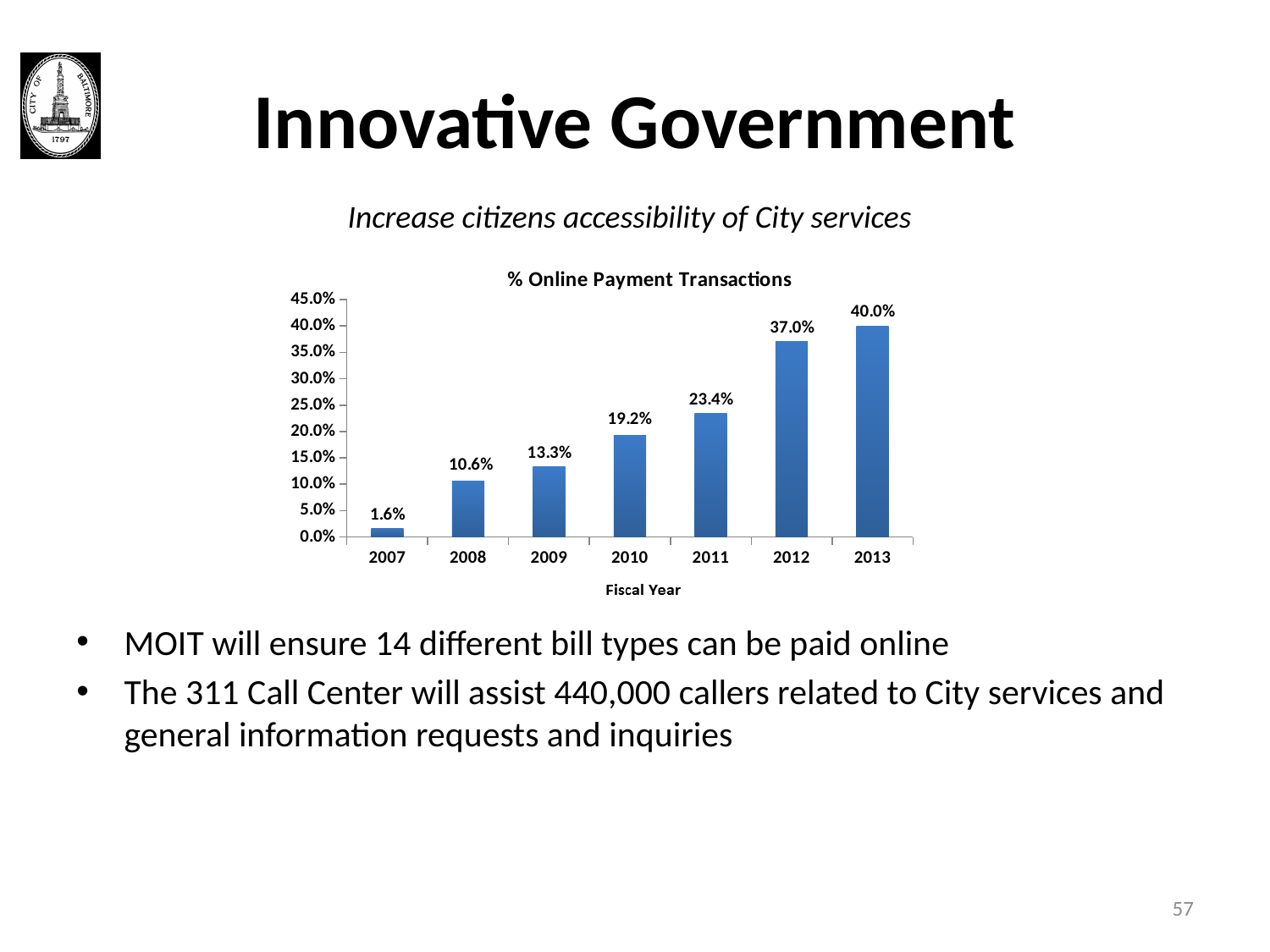
Is the value for 2011 greater or less than 20.0%? greater How many fiscal years are shown in the chart? 7 Do the % Online Payment Transactions values rise or fall from 2007 to 2013? Rise What is the % Online Payment Transactions value for fiscal year 2010? 19.2% Which fiscal year has the lowest % Online Payment Transactions? 2007 What is the difference in % Online Payment Transactions between 2013 and 2012? 3.0% What is the difference in % Online Payment Transactions between 2011 and 2010? 4.2% What is the % Online Payment Transactions value for fiscal year 2012? 37.0% What is the % Online Payment Transactions value for fiscal year 2007? 1.6% Which fiscal year has the highest % Online Payment Transactions? 2013 What kind of chart is used to show % Online Payment Transactions? Bar chart Which fiscal year has a larger % Online Payment Transactions, 2008 or 2009? 2009